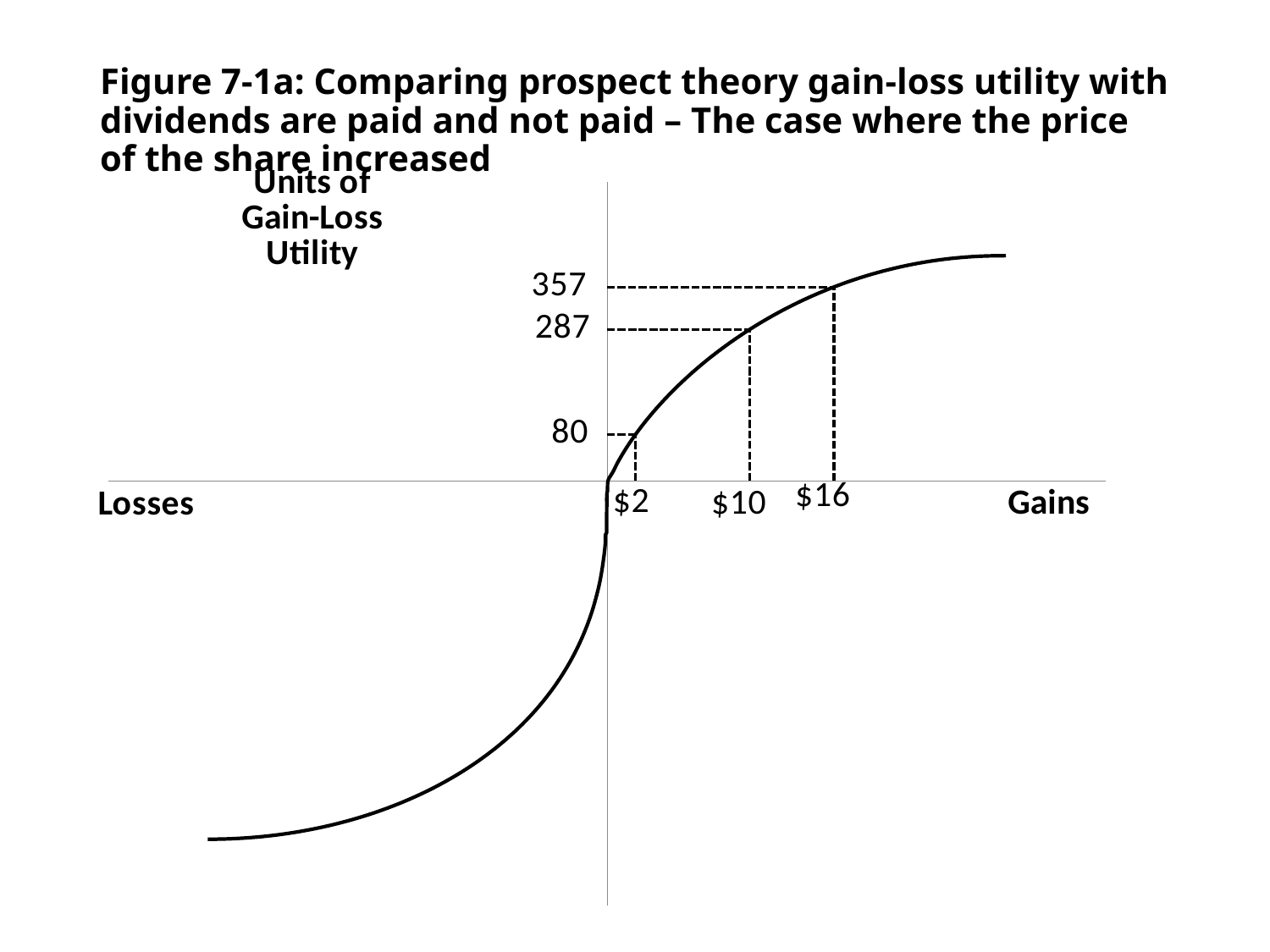
Which marked gain amount has the lowest gain-loss utility? $2 What kind of chart is shown on the slide? line chart Which has the larger gain-loss utility, a gain of $2 or a gain of $10? $10 What is the gain-loss utility value marked for a gain of $10? 287 What is the gain-loss utility value marked for a gain of $16? 357 Does the gain-loss utility rise or fall as gains increase along the x axis? rise What is the difference in gain-loss utility between a gain of $16 and a gain of $10? 70 What is the difference in gain-loss utility between a gain of $10 and a gain of $2? 207 Which marked gain amount has the highest gain-loss utility? $16 What is the gain-loss utility value marked for a gain of $2? 80 What is the label on the vertical axis of the chart? Units of Gain-Loss Utility How many gain amounts are marked with dashed lines on the x axis? 3